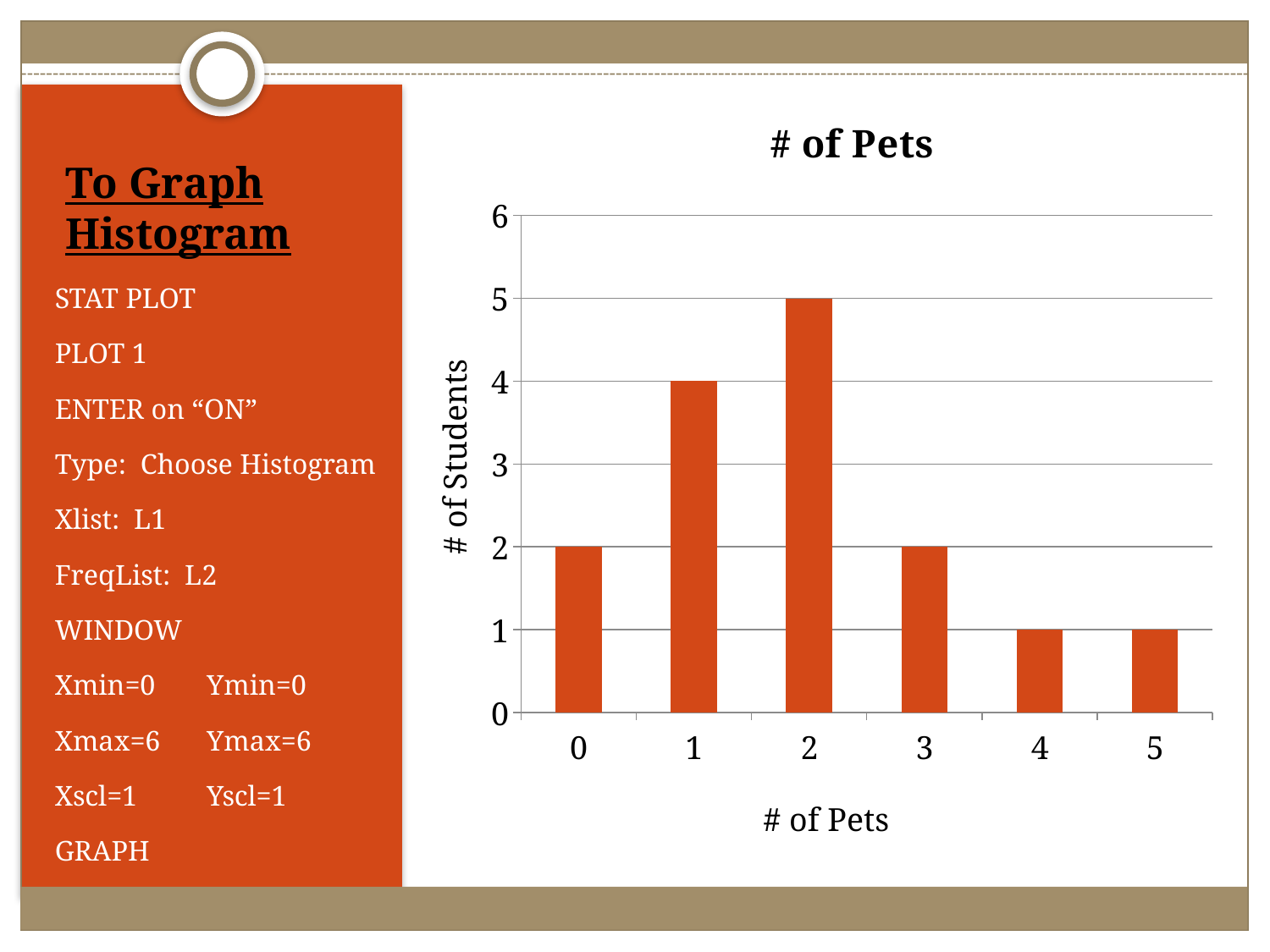
How many students have 4 pets? 1 Which is larger: the number of students with 3 pets or the number with 4 pets? 3 pets How many students have 2 pets? 5 How many categories are shown on the x axis? 6 Which number of pets has the highest number of students? 2 What is the label of the vertical axis? # of Students What is the difference between the number of students with 2 pets and the number with 1 pet? 1 How many students have 1 pet? 4 How many students have 0 pets? 2 What is the title of the chart? # of Pets What kind of chart is shown on the slide? bar chart Is the number of students with 1 pet greater or less than 3? greater